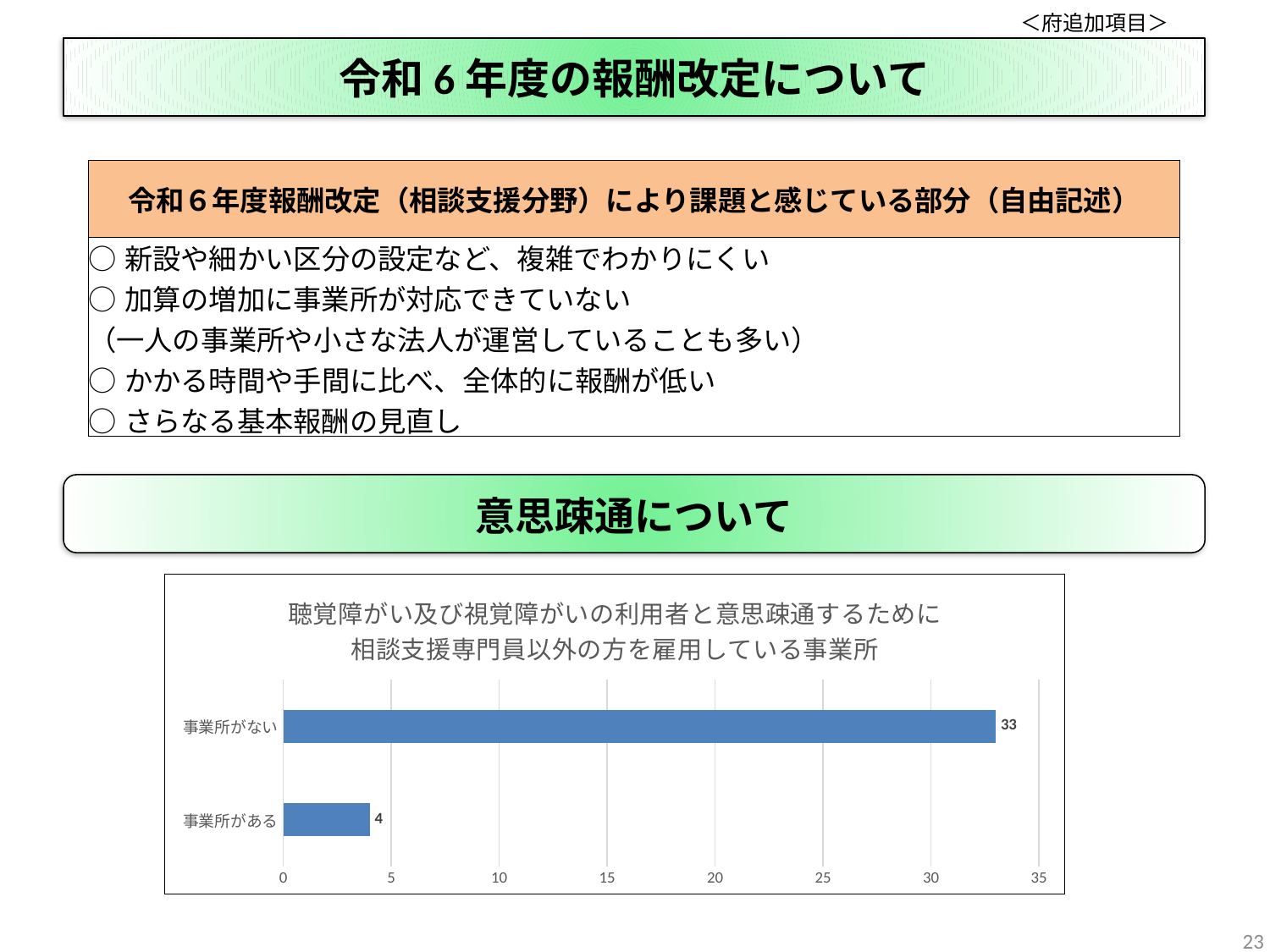
What is the total of the two values shown in the chart? 37 What is the value for 事業所がない? 33 Which is larger, the value for 事業所がない or the value for 事業所がある? 事業所がない What is the value for 事業所がある? 4 Which category has the lowest value? 事業所がある What is the maximum value shown on the x axis of the chart? 35 Which category has the highest value? 事業所がない Is the value for 事業所がある greater or less than 5? less How many categories are shown in the chart? 2 What is the difference between the values for 事業所がない and 事業所がある? 29 What kind of chart is shown on the slide? bar chart Is the value for 事業所がない greater or less than 30? greater